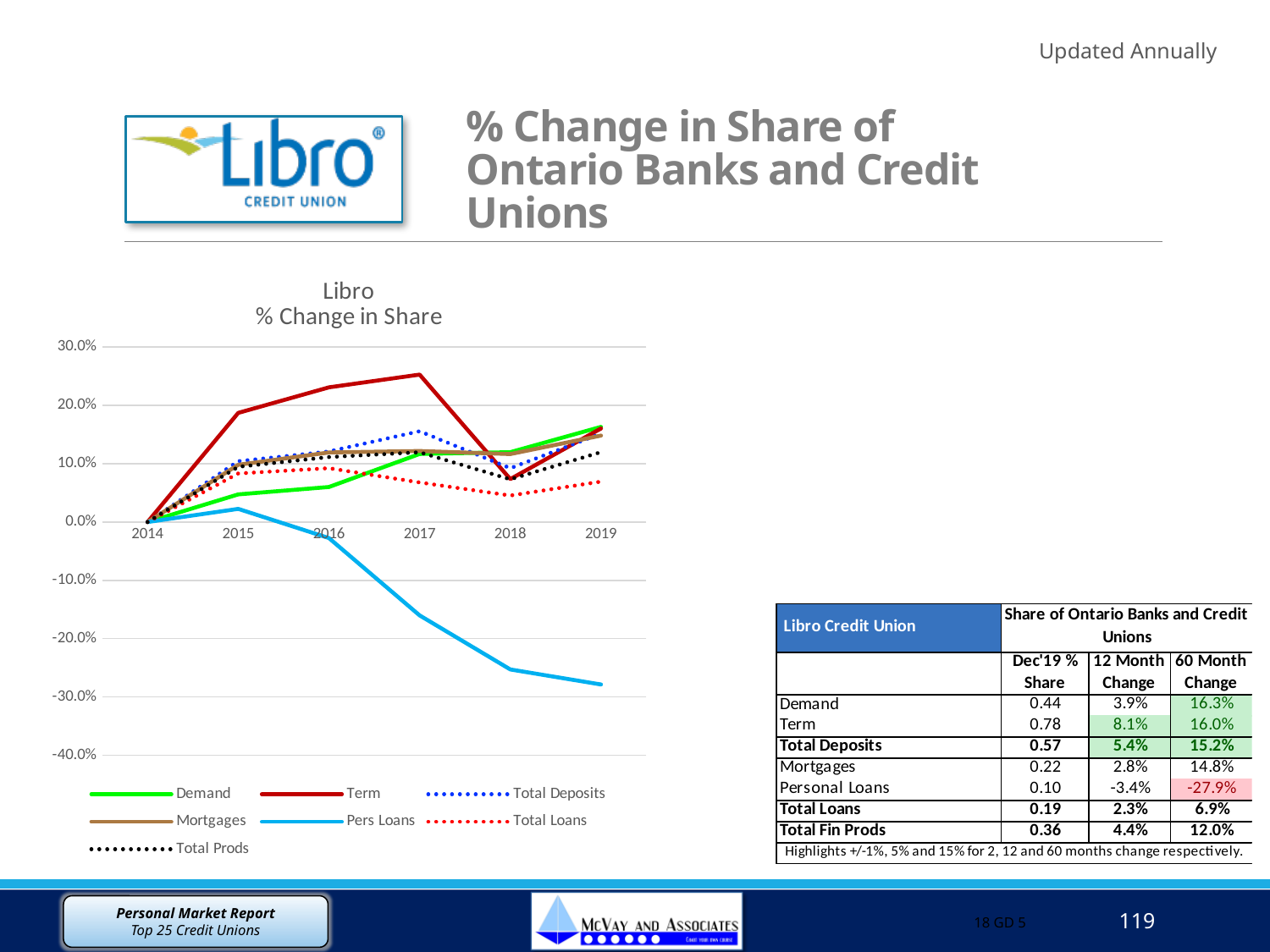
How many years are shown along the x axis of the chart? 6 Is the value for Term in 2017 greater or less than 20.0%? greater What is the title of the chart? Libro % Change in Share Does the Pers Loans series rise or fall from 2015 to 2019? fall Which is larger in 2016, the value for Term or the value for Demand? Term What kind of chart is shown on the slide? line chart How many series does the legend of the chart list? 7 Is the value for Demand in 2015 greater or less than 10.0%? less Which series has the highest value in 2015? Term Which series has the highest value in 2017? Term Is the value for Pers Loans in 2019 greater or less than -20.0%? less Which series has the lowest value in 2019? Pers Loans